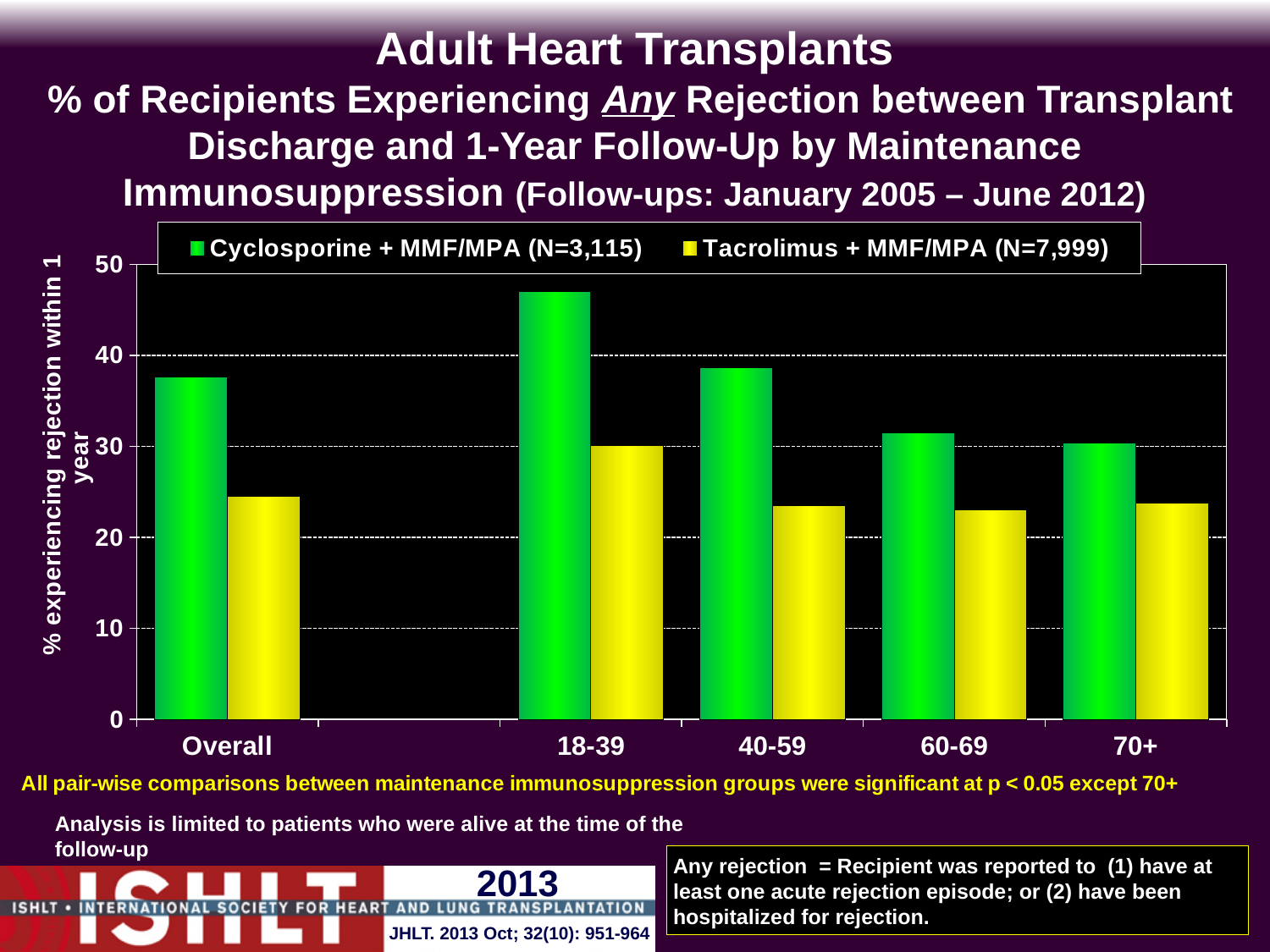
Is the value for Cyclosporine + MMF/MPA in the 18-39 group greater or less than 40? greater How many age categories (including Overall) are shown on the x axis? 5 Which age group has the highest value for Cyclosporine + MMF/MPA? 18-39 Which age group has the highest value for Tacrolimus + MMF/MPA? 18-39 Is the Overall value for Tacrolimus + MMF/MPA greater or less than 30? less What kind of chart is shown on the slide? bar chart Do the Cyclosporine + MMF/MPA values rise or fall across the age groups from 18-39 to 70+? fall What is the N given in the legend for Tacrolimus + MMF/MPA? N=7,999 In the 70+ group, which series has the larger value, Cyclosporine + MMF/MPA or Tacrolimus + MMF/MPA? Cyclosporine + MMF/MPA Is the Overall value for Cyclosporine + MMF/MPA greater or less than 40? less How many series does the legend list? 2